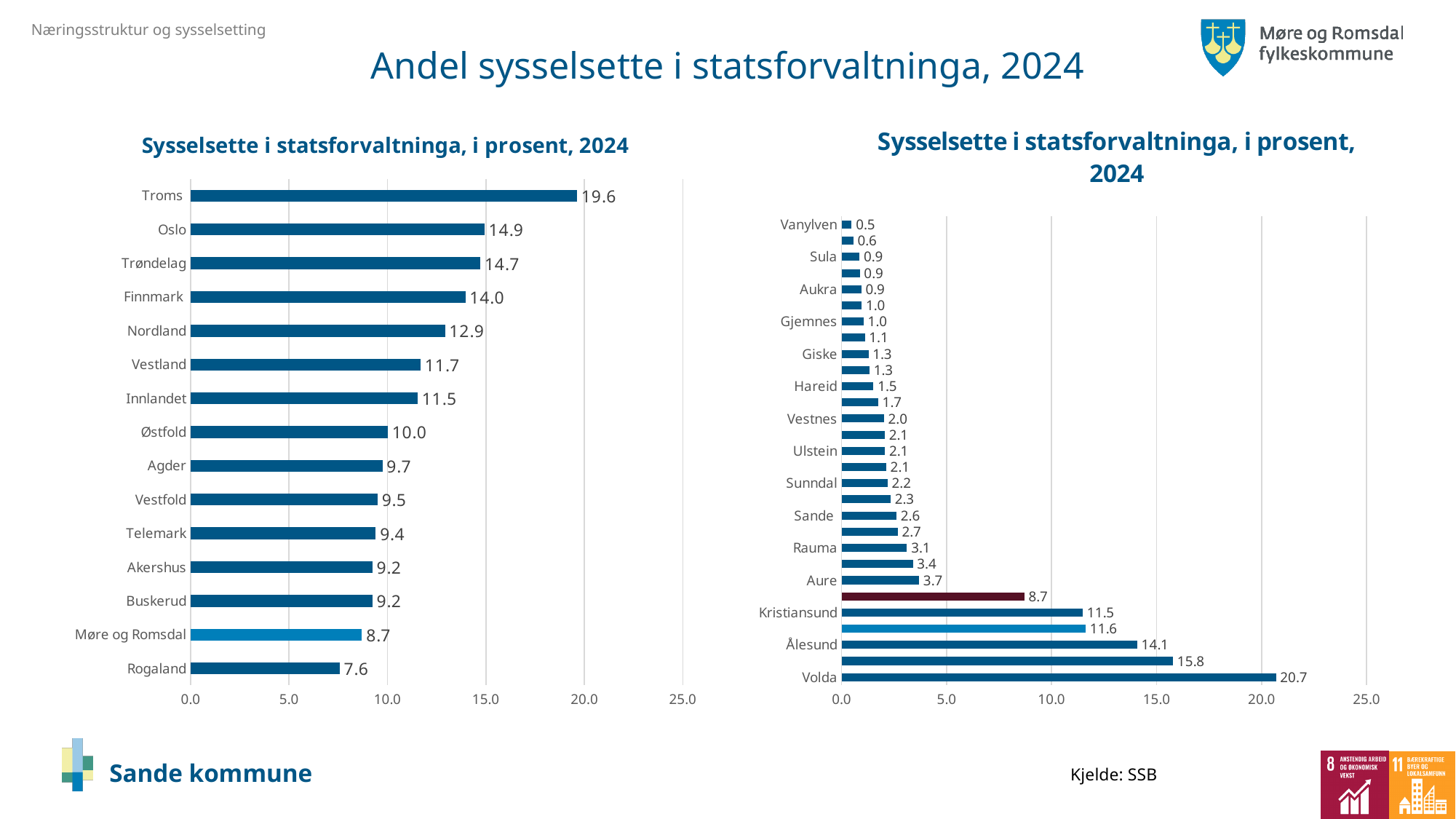
On the right chart, what is the value for Sande? 2.6 On the left chart, which county has the highest value? Troms What kind of chart is the left chart? Bar chart On the left chart, what is the value for Troms? 19.6 On the right chart, what is the value for Volda? 20.7 On the left chart, how many counties are shown? 15 On the left chart, what is the value for Møre og Romsdal? 8.7 On the right chart, which municipality has the highest value? Volda On the right chart, what is the difference between the values for Volda and Ålesund? 6.6 On the left chart, which county has the lowest value? Rogaland On the left chart, which is larger, the value for Nordland or the value for Vestland? Nordland On the left chart, what is the difference between the values for Oslo and Trøndelag? 0.2